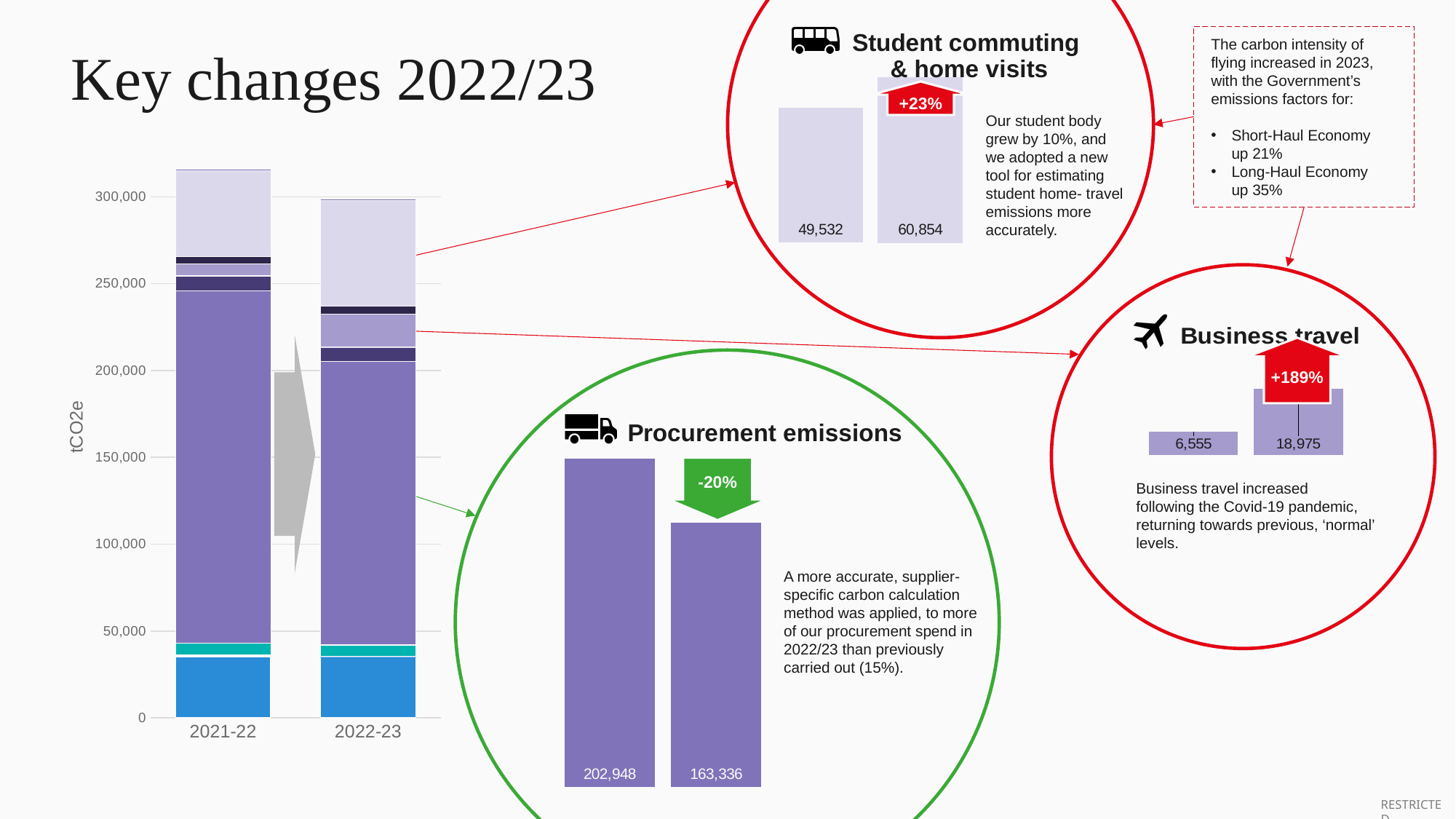
What kind of chart is the chart on the left of the slide with the tCO2e axis? stacked bar chart In the stacked chart on the left of the slide, is the total for 2021-22 greater or less than 300,000? greater In the stacked chart on the left of the slide, how many categories are shown on the x axis? 2 In the 'Student commuting & home visits' chart, what is the value of the right-hand bar? 60,854 In the 'Procurement emissions' chart, what percentage change is shown on the arrow? -20% In the 'Business travel' chart, what percentage change is shown on the arrow? +189% In the 'Student commuting & home visits' chart, what is the value of the left-hand bar? 49,532 In the 'Business travel' chart, which bar is larger, the left or the right? right In the 'Procurement emissions' chart, what is the difference between the two bars? 39,612 In the 'Business travel' chart, what is the value of the right-hand bar? 18,975 In the 'Business travel' chart, what is the difference between the two bars? 12,420 In the 'Procurement emissions' chart, what is the value of the left-hand bar? 202,948